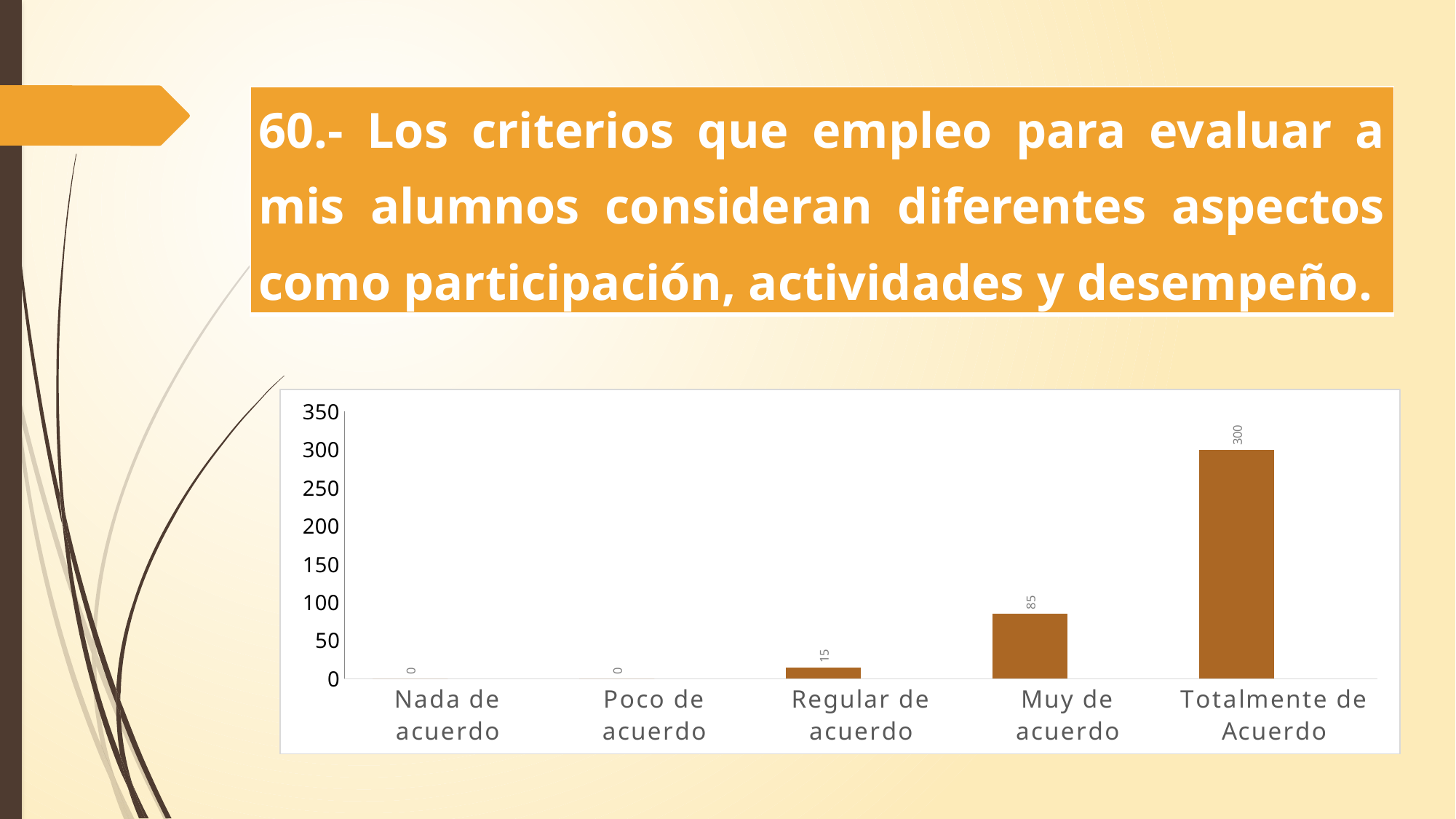
What kind of chart is shown on the slide? bar chart Which category has the highest value? Totalmente de Acuerdo What is the value for "Totalmente de Acuerdo"? 300 What is the value for "Regular de acuerdo"? 15 What is the difference between the values for "Totalmente de Acuerdo" and "Muy de acuerdo"? 215 Do the values rise or fall from left to right along the x axis? rise How many categories are shown on the x axis? 5 Is the value for "Muy de acuerdo" greater or less than 100? less What is the value for "Nada de acuerdo"? 0 What is the value for "Muy de acuerdo"? 85 Which is larger, the value for "Muy de acuerdo" or the value for "Regular de acuerdo"? Muy de acuerdo What is the difference between the values for "Muy de acuerdo" and "Regular de acuerdo"? 70